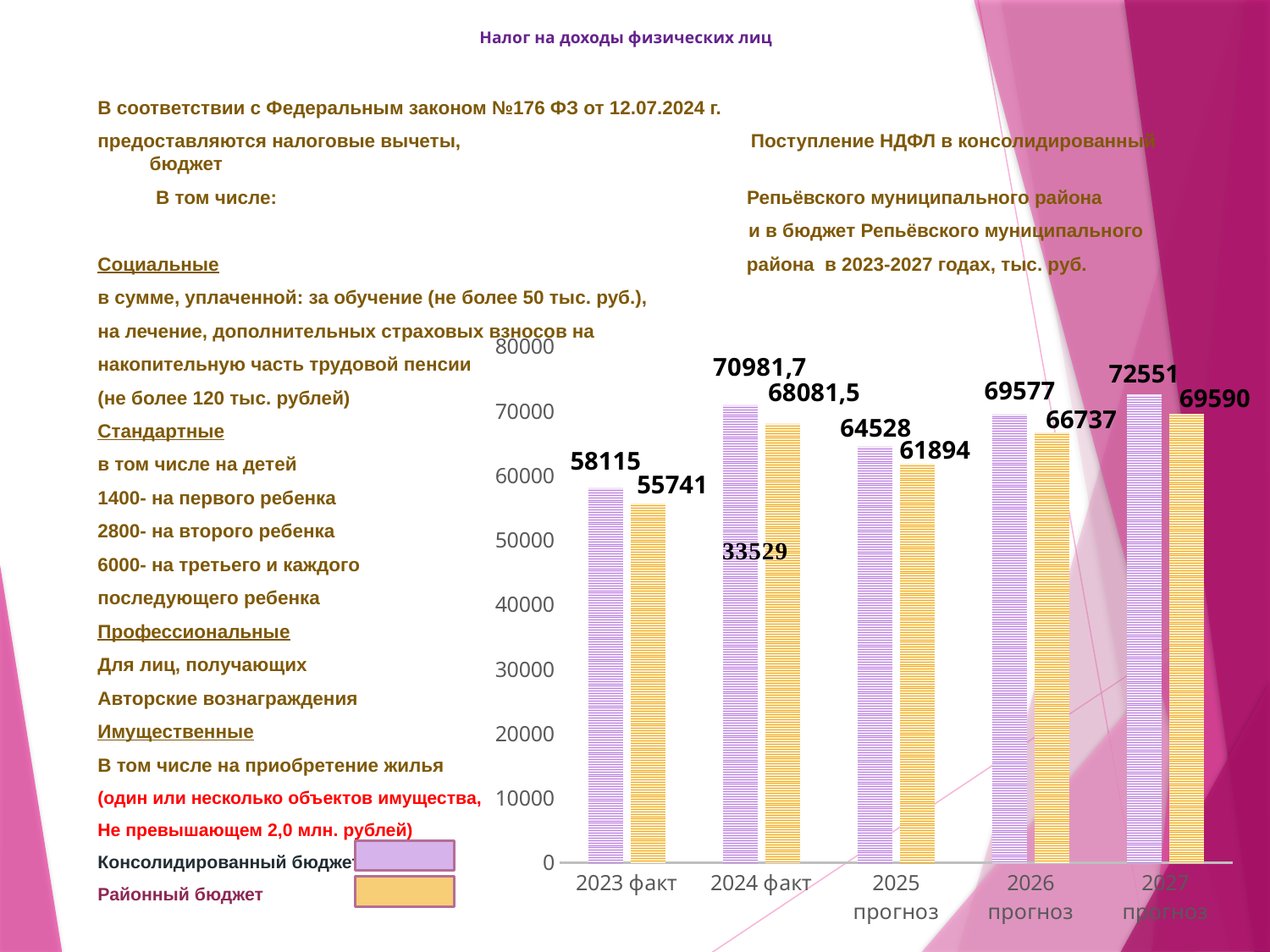
In which year is the value for Консолидированный бюджет the highest? 2027 прогноз What is the value for Консолидированный бюджет in 2023 факт? 58115 What is the value for Районный бюджет in 2024 факт? 68081,5 In which year is the value for Районный бюджет the lowest? 2023 факт Which is larger: Консолидированный бюджет in 2024 факт or in 2026 прогноз? 2024 факт What is the difference between Консолидированный бюджет and Районный бюджет in 2023 факт? 2374 Is the value for Районный бюджет in 2025 прогноз greater or less than 60000? greater What is the value for Консолидированный бюджет in 2025 прогноз? 64528 How many years (categories) are shown on the x axis of the chart? 5 What is the difference between Консолидированный бюджет and Районный бюджет in 2027 прогноз? 2961 What kind of chart is shown on the slide? bar chart What is the value for Районный бюджет in 2027 прогноз? 69590